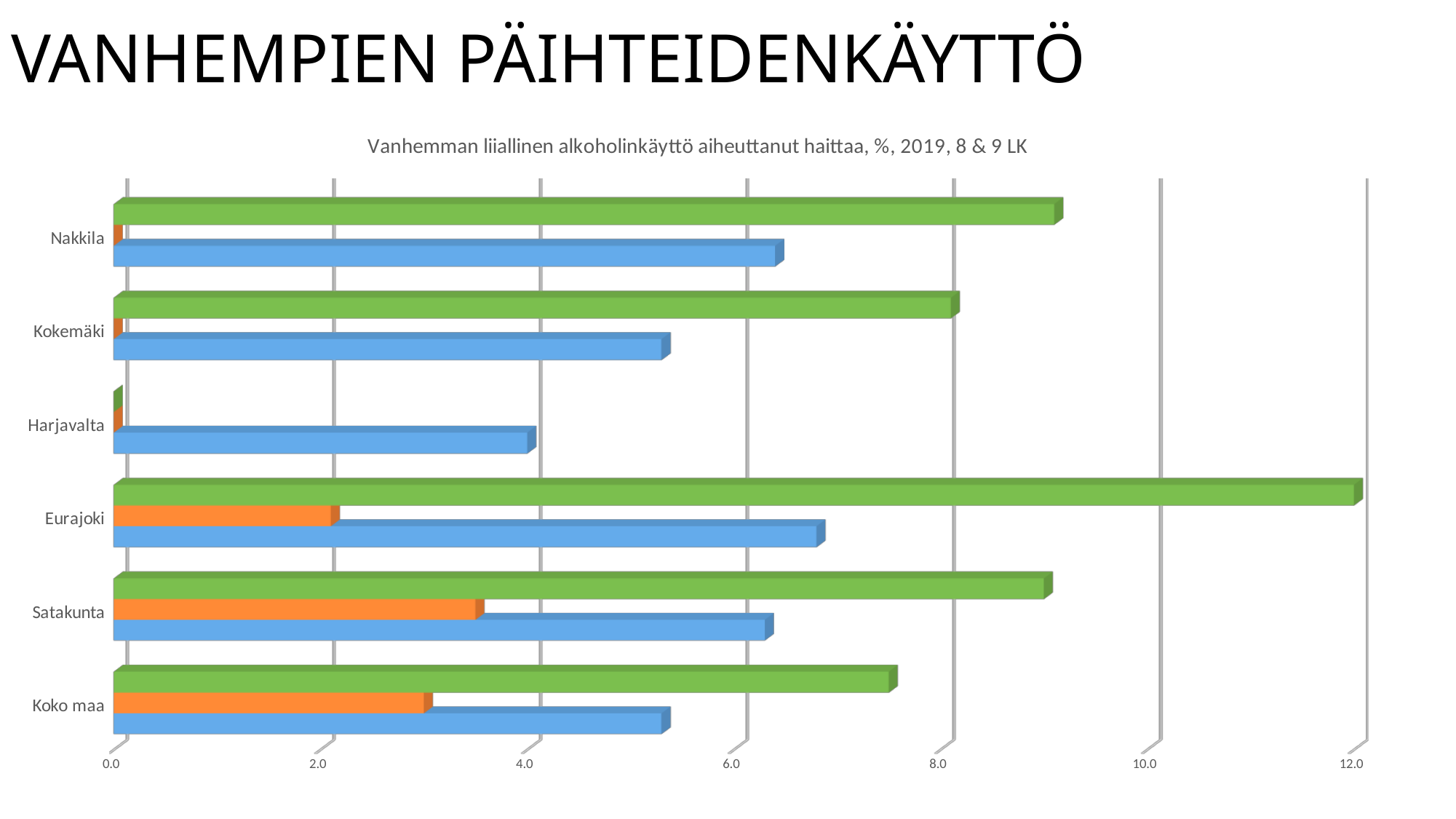
Which is larger, the blue bar for Nakkila or the blue bar for Kokemäki? Nakkila Which category has the longest green bar? Eurajoki Which category has the shortest green bar? Harjavalta Is the orange bar for Koko maa greater or less than 2.0? greater How many categories are shown on the vertical axis of the chart? 6 Is the green bar for Nakkila greater or less than 8.0? greater Is the orange bar for Satakunta greater or less than 4.0? less What kind of chart is shown on the slide? bar chart What is the title of the chart? Vanhemman liiallinen alkoholinkäyttö aiheuttanut haittaa, %, 2019, 8 & 9 LK Which is larger, the green bar for Koko maa or the green bar for Satakunta? Satakunta